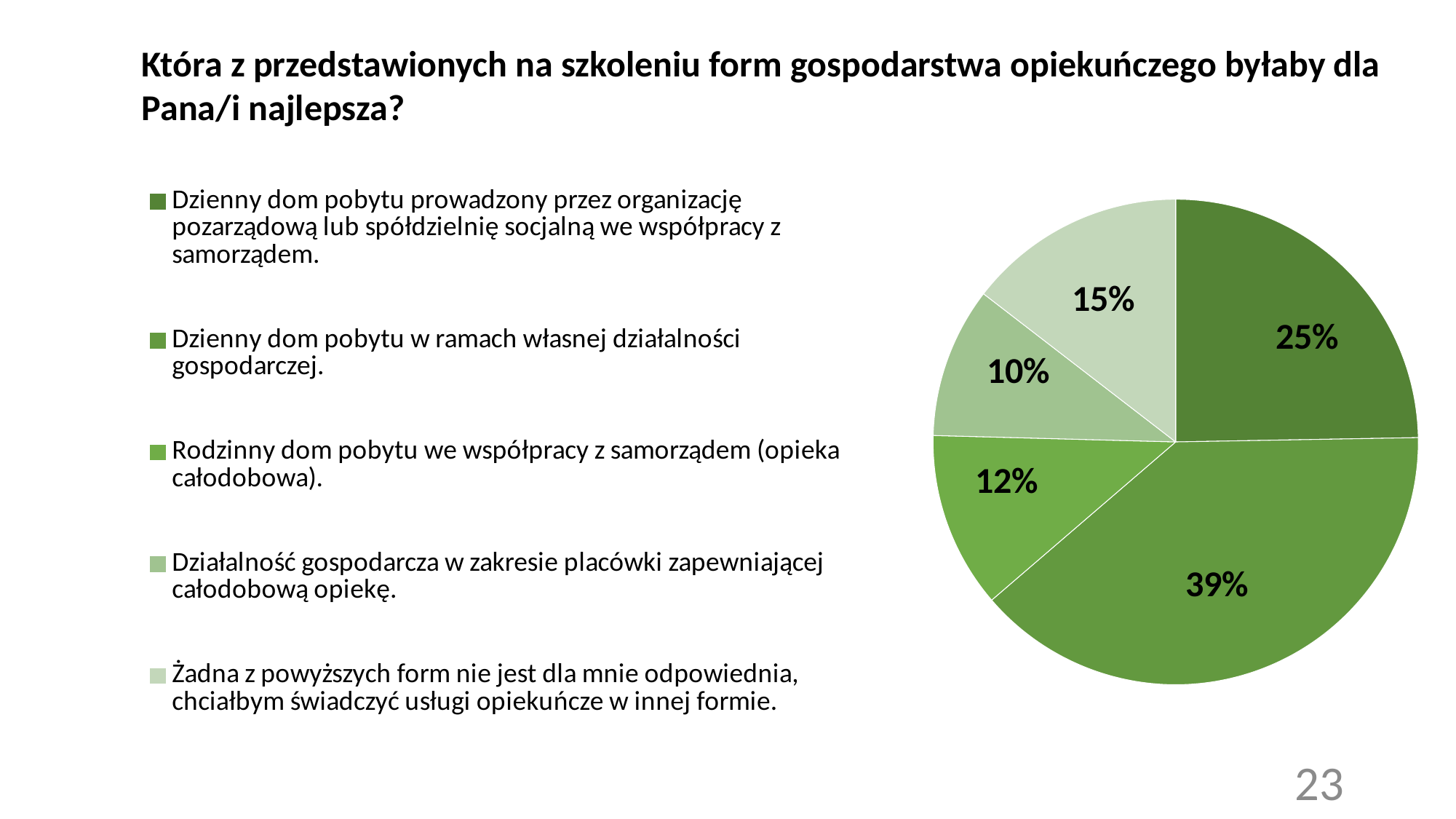
Which option has the largest share of the pie? Dzienny dom pobytu w ramach własnej działalności gospodarczej. What is the title of the slide above the chart? Która z przedstawionych na szkoleniu form gospodarstwa opiekuńczego byłaby dla Pana/i najlepsza? What is the difference in percentage points between the largest slice (39%) and the slice for "Dzienny dom pobytu prowadzony przez organizację pozarządową..." (25%)? 14 percentage points What share of respondents chose "Żadna z powyższych form nie jest dla mnie odpowiednia, chciałbym świadczyć usługi opiekuńcze w innej formie"? 15% What type of chart is shown on the slide? pie chart Which is larger: the share for "Żadna z powyższych form..." or the share for "Rodzinny dom pobytu we współpracy z samorządem"? Żadna z powyższych form nie jest dla mnie odpowiednia, chciałbym świadczyć usługi opiekuńcze w innej formie. What share of respondents chose "Dzienny dom pobytu prowadzony przez organizację pozarządową lub spółdzielnię socjalną we współpracy z samorządem"? 25% Which option has the smallest share of the pie? Działalność gospodarcza w zakresie placówki zapewniającej całodobową opiekę. How many slices does the pie chart have? 5 What share of respondents chose "Dzienny dom pobytu w ramach własnej działalności gospodarczej"? 39% What share of respondents chose "Działalność gospodarcza w zakresie placówki zapewniającej całodobową opiekę"? 10% What share of respondents chose "Rodzinny dom pobytu we współpracy z samorządem (opieka całodobowa)"? 12%